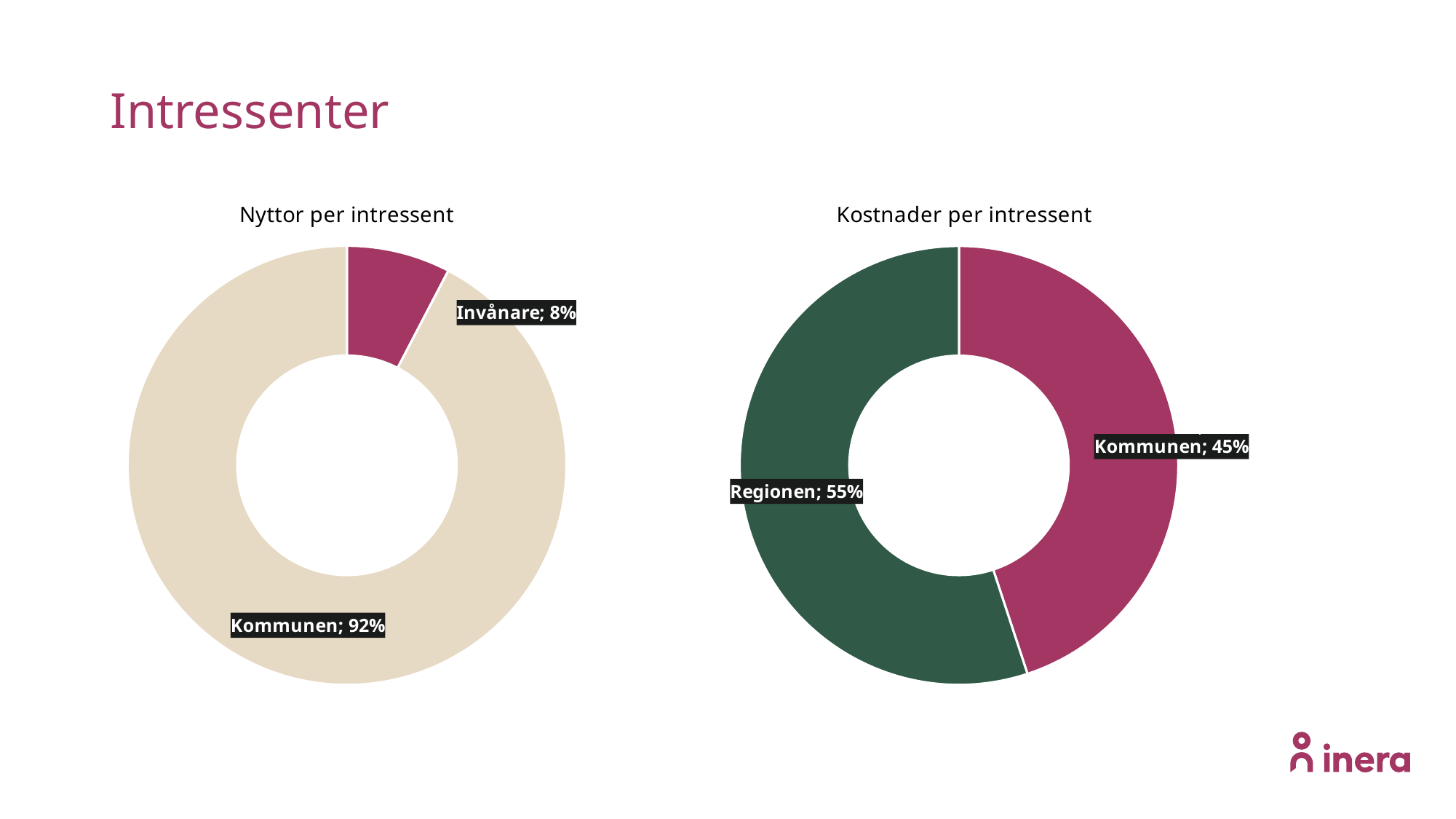
In the 'Kostnader per intressent' chart, what share is labelled for Regionen? 55% In the 'Kostnader per intressent' chart, what share is labelled for Kommunen? 45% In the 'Nyttor per intressent' chart, what share is labelled for Kommunen? 92% How many slices does the 'Nyttor per intressent' chart have? 2 In the 'Kostnader per intressent' chart, which category has the smallest slice? Kommunen In the 'Kostnader per intressent' chart, which is larger, Regionen or Kommunen? Regionen In the 'Nyttor per intressent' chart, which category has the largest slice? Kommunen In the 'Nyttor per intressent' chart, what is the difference in percentage points between Kommunen and Invånare? 84 In the 'Nyttor per intressent' chart, what share is labelled for Invånare? 8% What is the title of the chart on the left side of the slide? Nyttor per intressent What kind of chart is 'Kostnader per intressent'? Doughnut (pie) chart In the 'Kostnader per intressent' chart, what is the difference in percentage points between Regionen and Kommunen? 10